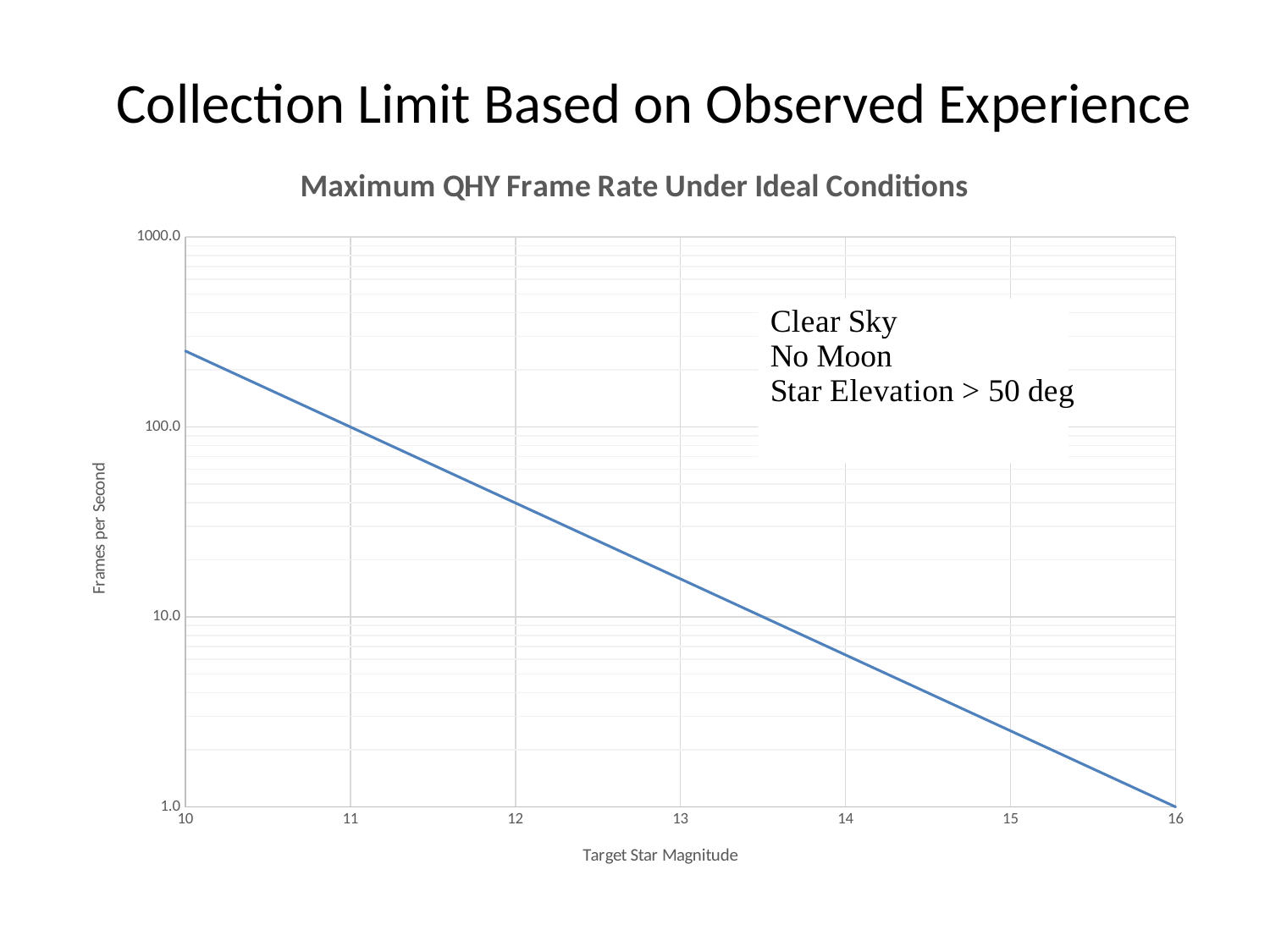
What is the frames per second value at target star magnitude 11? 100.0 What is the frames per second value at target star magnitude 16? 1.0 What is the label of the x axis? Target Star Magnitude Is the frames per second value at magnitude 10 greater or less than 100.0? greater What is the title of the chart? Maximum QHY Frame Rate Under Ideal Conditions Do the frames per second rise or fall as target star magnitude increases? fall Is the frames per second value at magnitude 14 greater or less than 10.0? less Is the frames per second value at magnitude 12 greater or less than 100.0? less Which target star magnitude has the highest frames per second, 10 or 16? 10 What kind of chart is shown on the slide? line chart